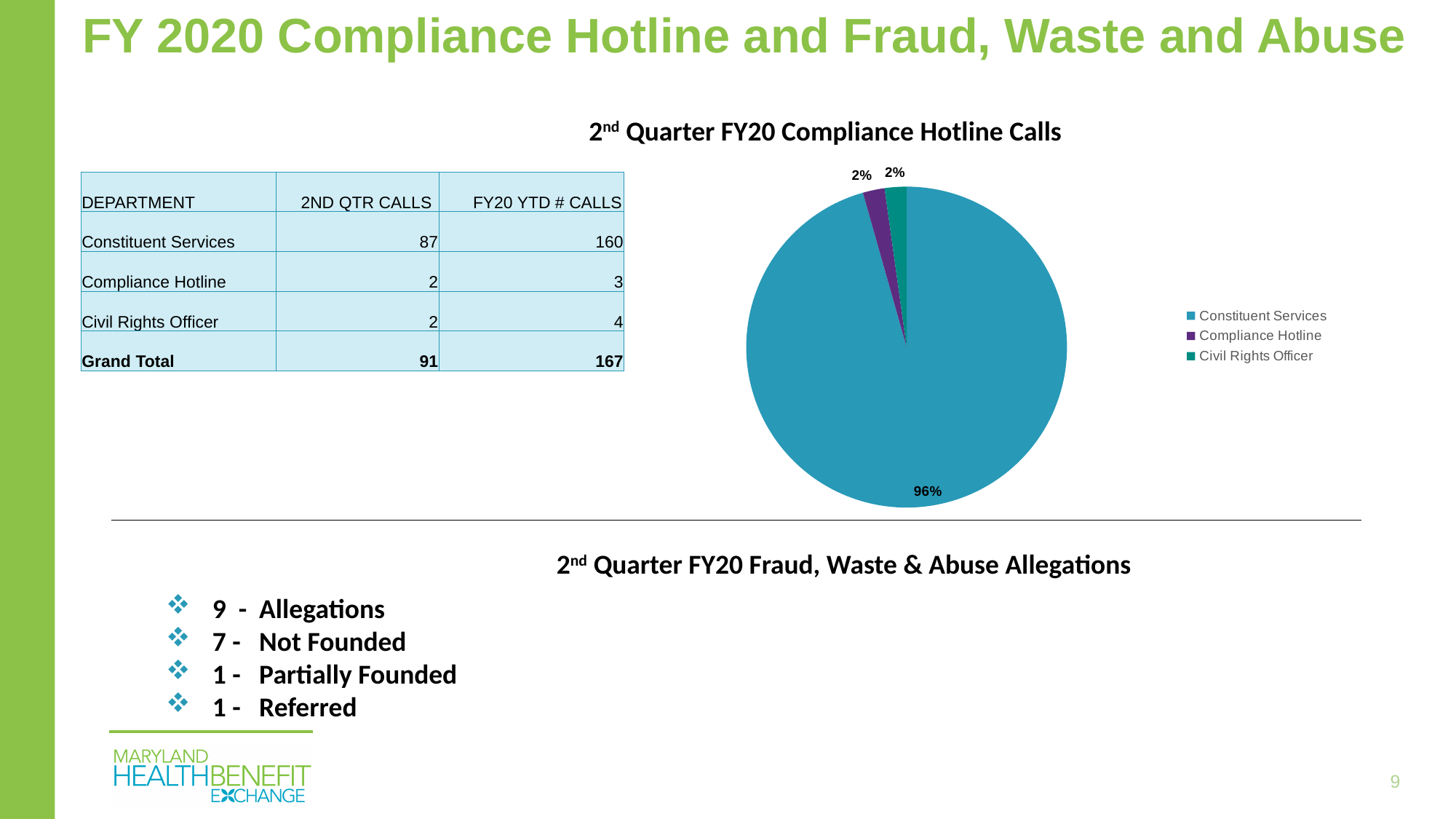
What share of the pie chart does Constituent Services represent? 96% Which category has the largest slice in the pie chart? Constituent Services How many slices does the pie chart have? 3 What percentage is shown for Compliance Hotline in the pie chart? 2% What kind of chart is shown on the slide? pie chart What is the title of the pie chart? 2nd Quarter FY20 Compliance Hotline Calls Which is larger in the pie chart, Constituent Services or Compliance Hotline? Constituent Services What is the difference in percentage points between the Constituent Services slice and the Civil Rights Officer slice? 94 What percentage is shown for Civil Rights Officer in the pie chart? 2% Which category is shown in purple in the pie chart? Compliance Hotline How many entries does the pie chart's legend list? 3